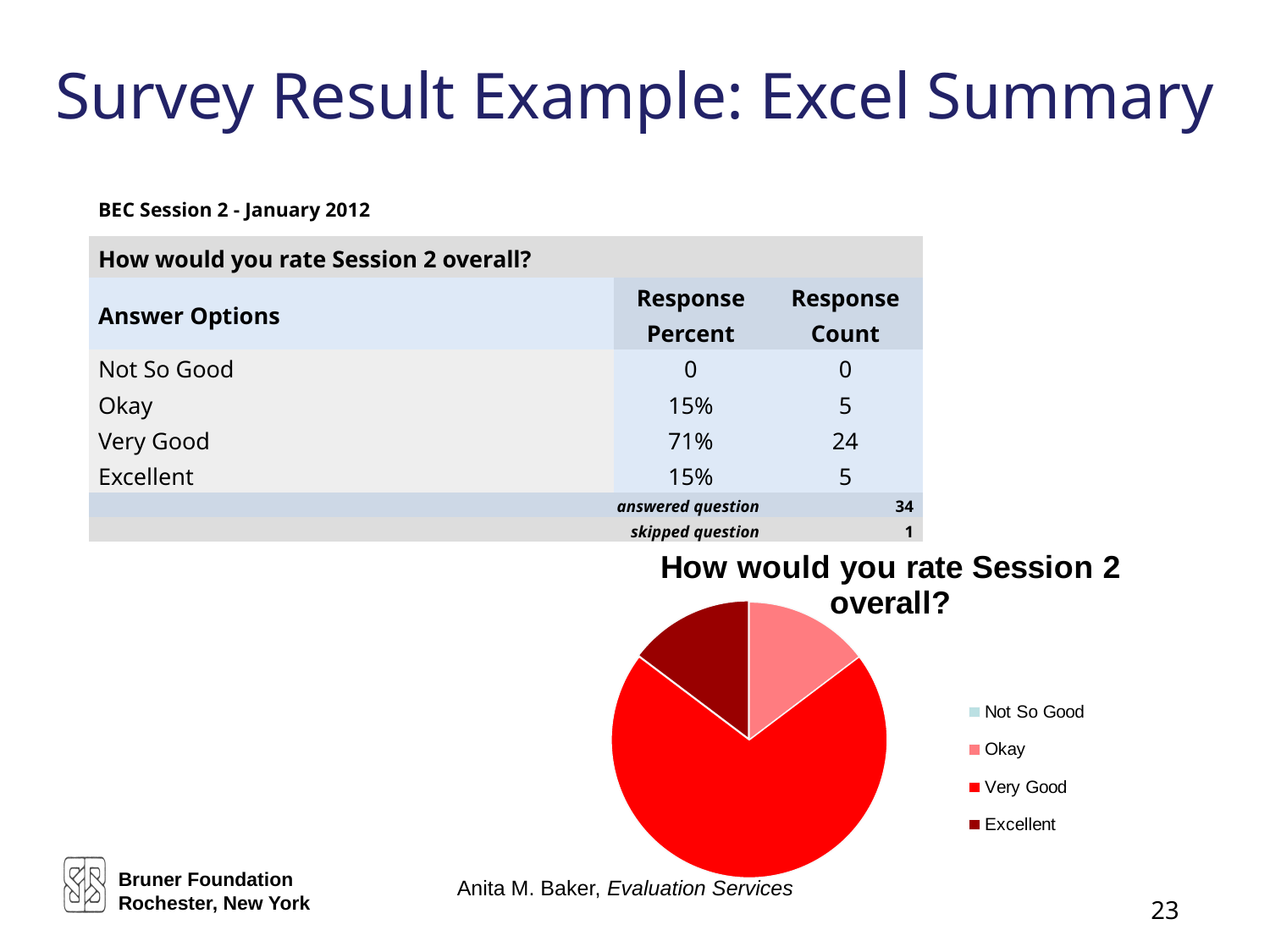
Which slice is larger, Very Good or Excellent? Very Good What share of the pie does Very Good represent? 71% What colour is the Very Good slice in the pie chart? red What is the title of the pie chart? How would you rate Session 2 overall? What is the response count for Very Good? 24 Which category has the smallest share of the pie chart? Not So Good How many categories does the pie chart's legend list? 4 What is the response count for Excellent? 5 Which category has the largest slice of the pie chart? Very Good What share of the pie does Okay represent? 15% What is the difference in response count between Very Good and Okay? 19 What kind of chart is shown on the slide? pie chart